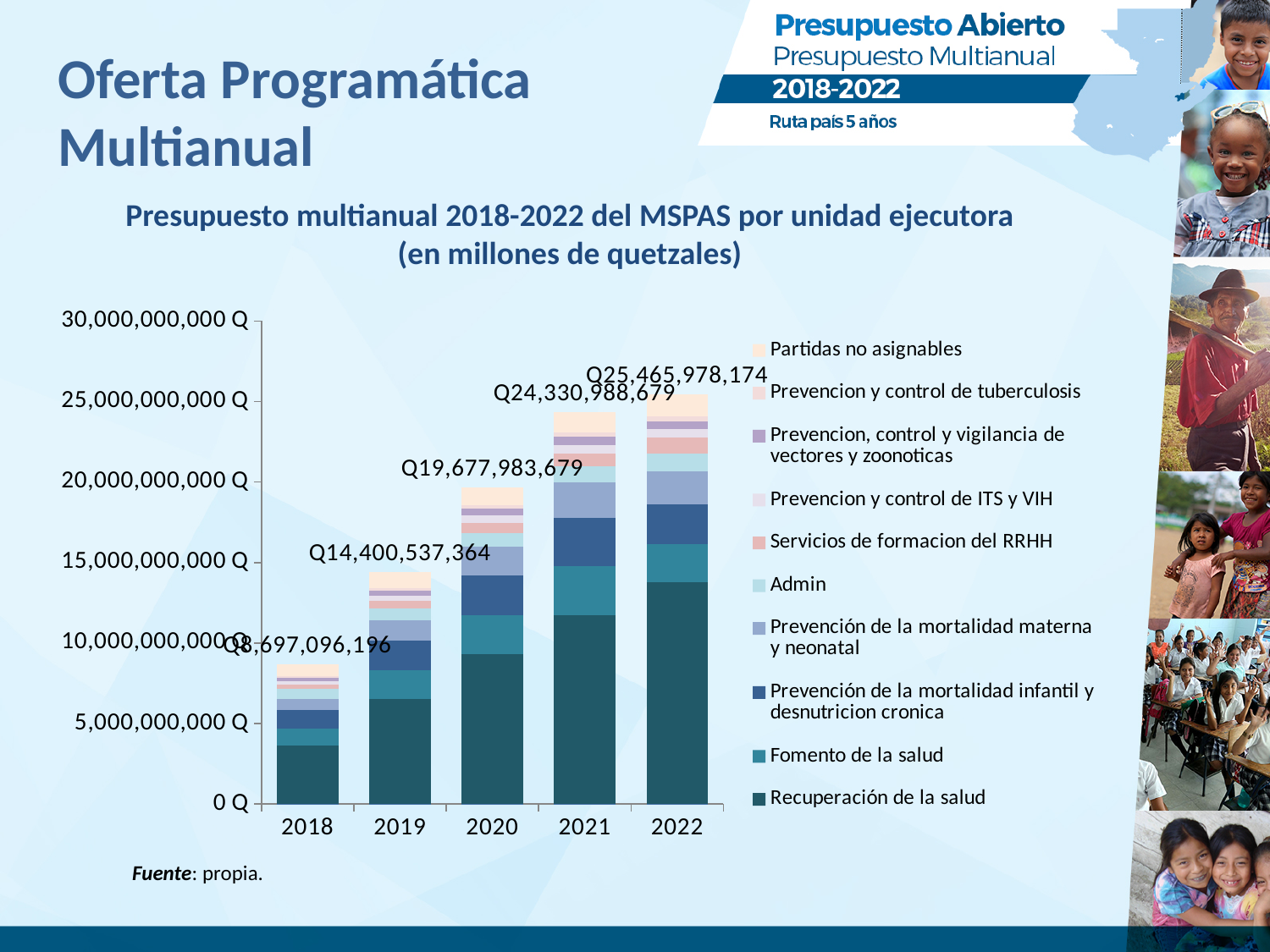
What is the total budget shown for 2022? Q25,465,978,174 Is the value for Recuperación de la salud in 2022 greater or less than 10,000,000,000 Q? greater Which year has the lowest total budget? 2018 What is the total budget shown for 2020? Q19,677,983,679 What is the difference between the total budgets for 2019 and 2018? Q5,703,441,168 Which year has the highest total budget? 2022 What is the total budget shown for 2018? Q8,697,096,196 How many series does the legend list? 10 What is the difference between the total budgets for 2022 and 2021? Q1,134,989,495 What kind of chart is shown on the slide? stacked bar chart Is the total budget for 2021 larger or smaller than the total for 2020? larger How many years are shown on the x axis? 5